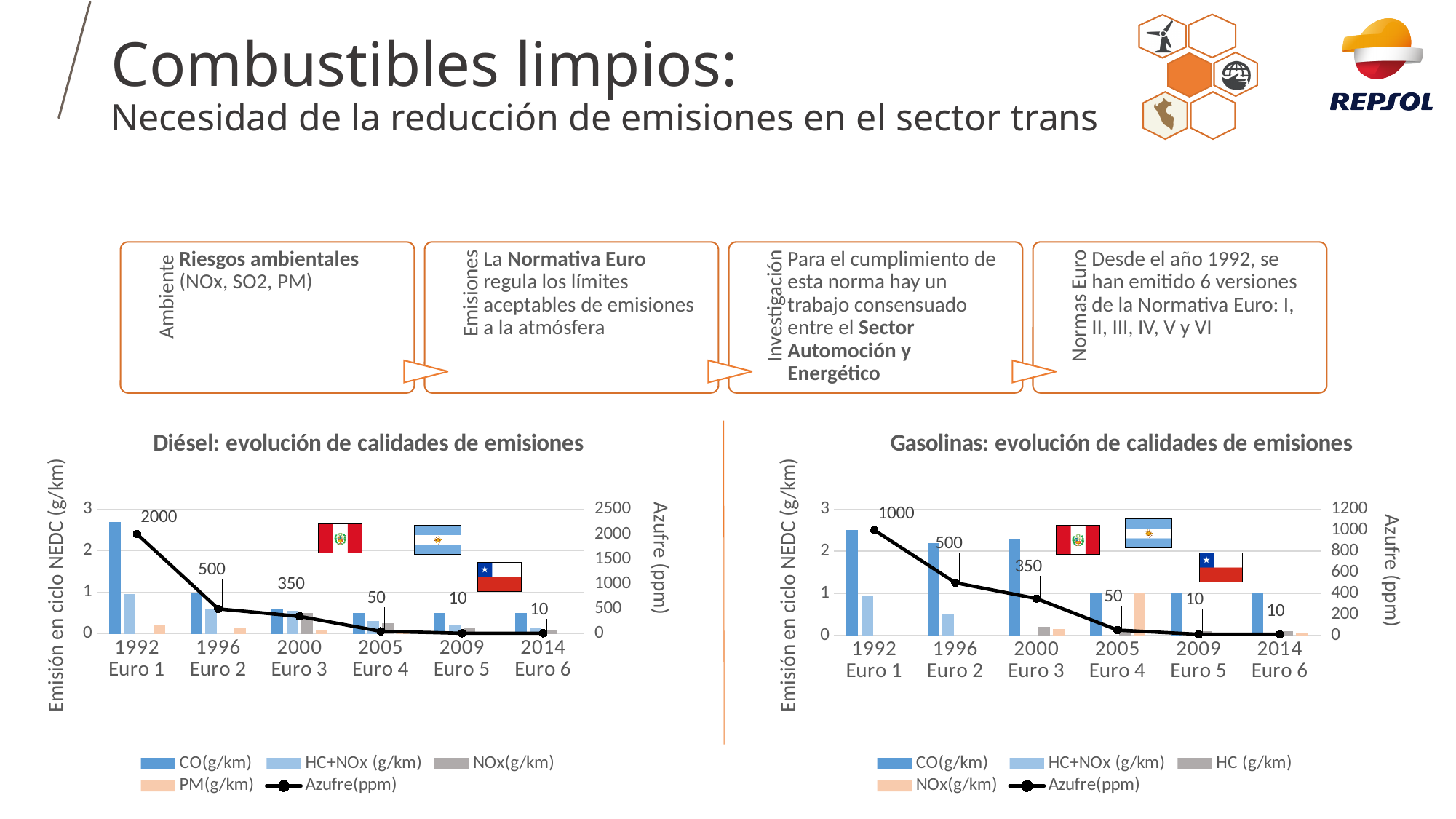
In the 'Diésel: evolución de calidades de emisiones' chart, what is the difference in Azufre (ppm) between 1996 Euro 2 and 2005 Euro 4? 450 In the 'Gasolinas: evolución de calidades de emisiones' chart, what is the difference in Azufre (ppm) between 1992 Euro 1 and 1996 Euro 2? 500 In the 'Gasolinas: evolución de calidades de emisiones' chart, which is larger, the CO(g/km) value for 1992 Euro 1 or for 2014 Euro 6? 1992 Euro 1 In the 'Gasolinas: evolución de calidades de emisiones' chart, what is the Azufre (ppm) value for 2005 Euro 4? 50 How many series does the legend of the 'Gasolinas: evolución de calidades de emisiones' chart list? 5 In the 'Diésel: evolución de calidades de emisiones' chart, is the CO(g/km) value for 1992 Euro 1 greater or less than 2? greater In the 'Gasolinas: evolución de calidades de emisiones' chart, does the Azufre (ppm) line rise or fall from 1992 to 2014? fall In the 'Diésel: evolución de calidades de emisiones' chart, what is the Azufre (ppm) value for 2000 Euro 3? 350 How many categories are shown on the x axis of the 'Diésel: evolución de calidades de emisiones' chart? 6 In the 'Diésel: evolución de calidades de emisiones' chart, which category has the highest Azufre (ppm) value? 1992 Euro 1 In the 'Diésel: evolución de calidades de emisiones' chart, what is the Azufre (ppm) value for 1992 Euro 1? 2000 In the 'Gasolinas: evolución de calidades de emisiones' chart, what is the Azufre (ppm) value for 1992 Euro 1? 1000